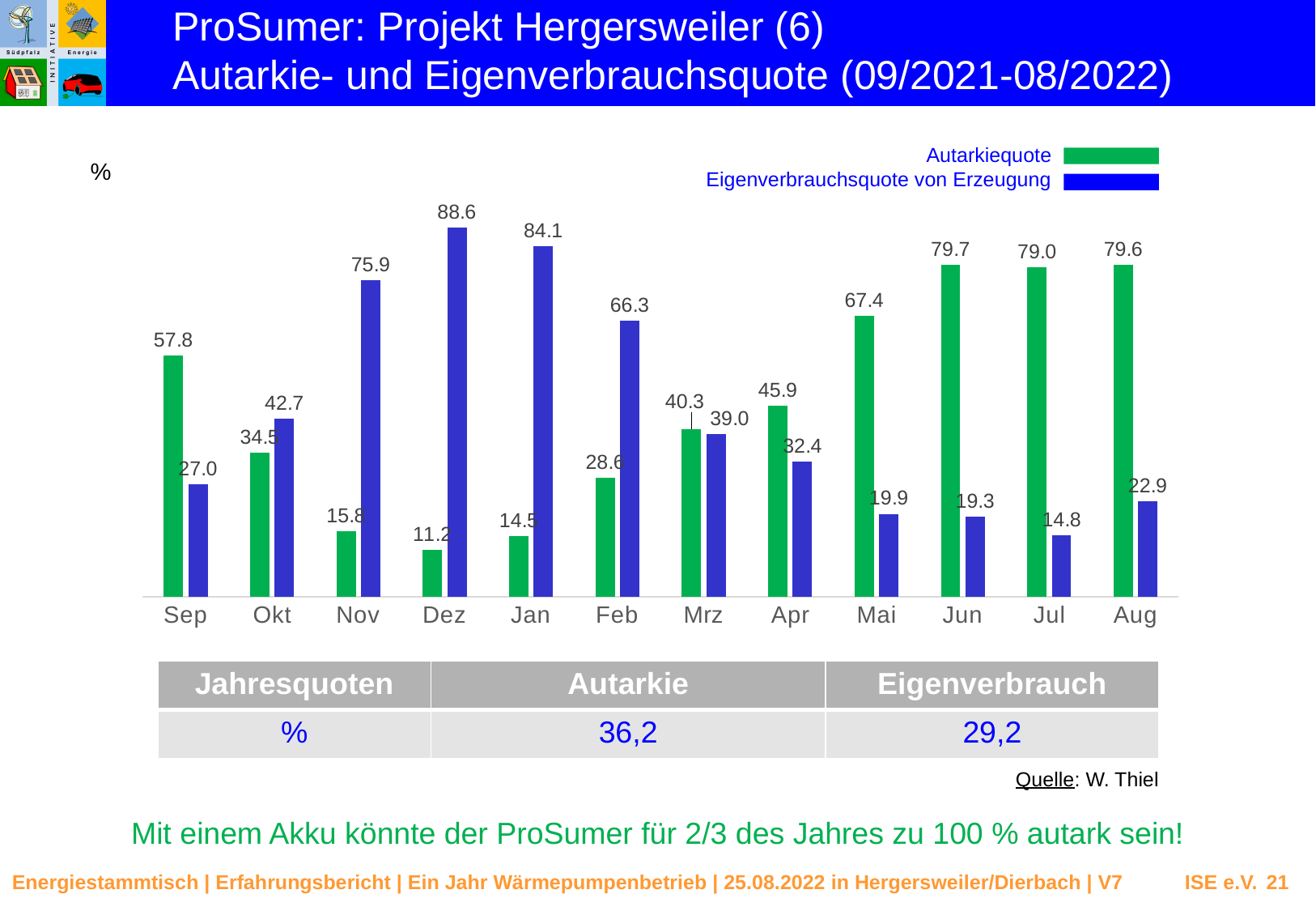
In which month is the Eigenverbrauchsquote von Erzeugung highest? Dez What is the Eigenverbrauchsquote von Erzeugung for Dez? 88.6 In Okt, which is larger: the Autarkiequote or the Eigenverbrauchsquote von Erzeugung? Eigenverbrauchsquote von Erzeugung How many series does the chart legend list? 2 How many months are shown on the x axis of the chart? 12 What is the Autarkiequote for Mai? 67.4 In which month is the Eigenverbrauchsquote von Erzeugung lowest? Jul What kind of chart is shown on the slide? Bar chart What is the difference between the Eigenverbrauchsquote von Erzeugung and the Autarkiequote in Dez? 77.4 In which month is the Autarkiequote lowest? Dez What is the Eigenverbrauchsquote von Erzeugung for Jul? 14.8 What is the Autarkiequote for Sep? 57.8